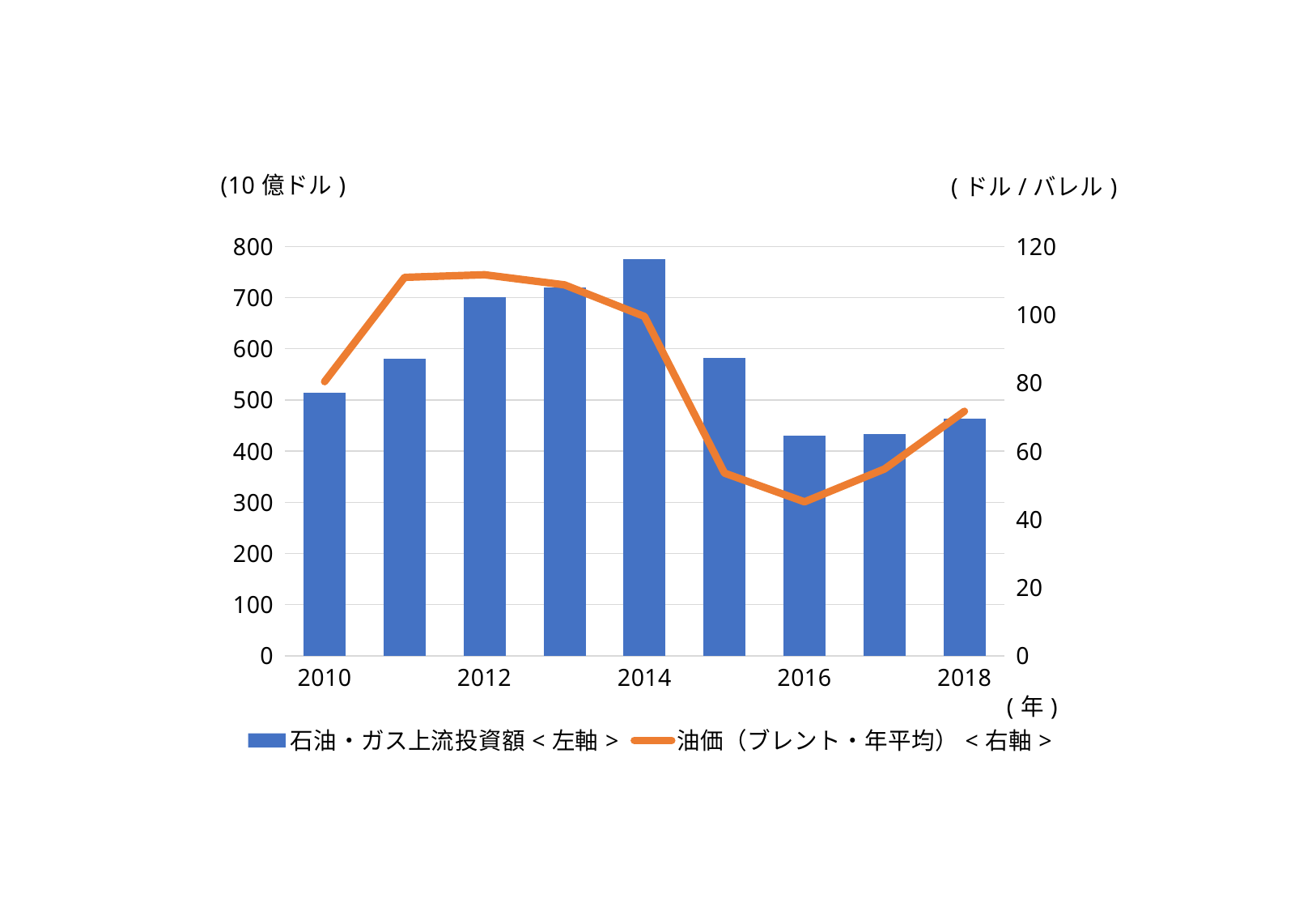
How many years are plotted along the x axis? 9 In which year is the 油価 line at its lowest point? 2016 Is the 油価 value for 2016 greater or less than 60 on the right axis? less Is the 石油・ガス上流投資額 bar for 2014 greater or less than 700? greater Is the 油価 value for 2012 greater or less than 100 on the right axis? greater Which year has the larger 石油・ガス上流投資額 bar, 2014 or 2016? 2014 What kind of chart is shown on the slide? A combined bar and line chart How many series does the legend list? 2 What unit is shown for the left axis? 10億ドル In which year is the bar for 石油・ガス上流投資額 the highest? 2014 Does the 油価 line rise or fall between 2014 and 2016? It falls